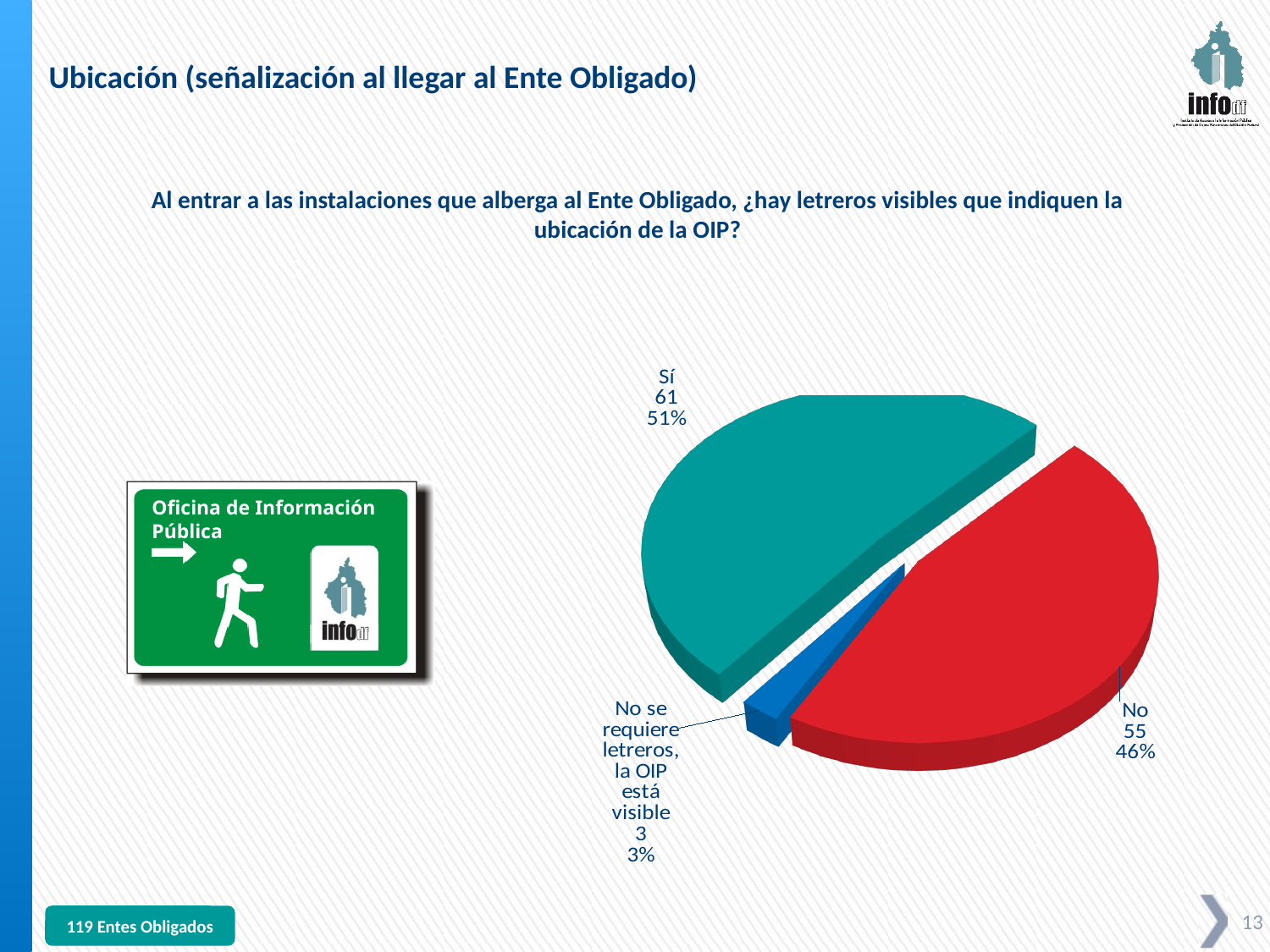
Which category has the smallest slice? No se requiere letreros, la OIP está visible Which category has the largest slice? Sí What is the value for the "Sí" slice? 61 What kind of chart is shown on the slide? pie chart What colour is the "No" slice? red What is the total of all three slices? 119 How many slices does the pie chart have? 3 What is the value for the "No se requiere letreros, la OIP está visible" slice? 3 What is the difference between the values for "Sí" and "No"? 6 Which is larger, the value for "No" or the value for "No se requiere letreros, la OIP está visible"? No What percentage share does the "Sí" slice represent? 51% What percentage share does the "No" slice represent? 46%